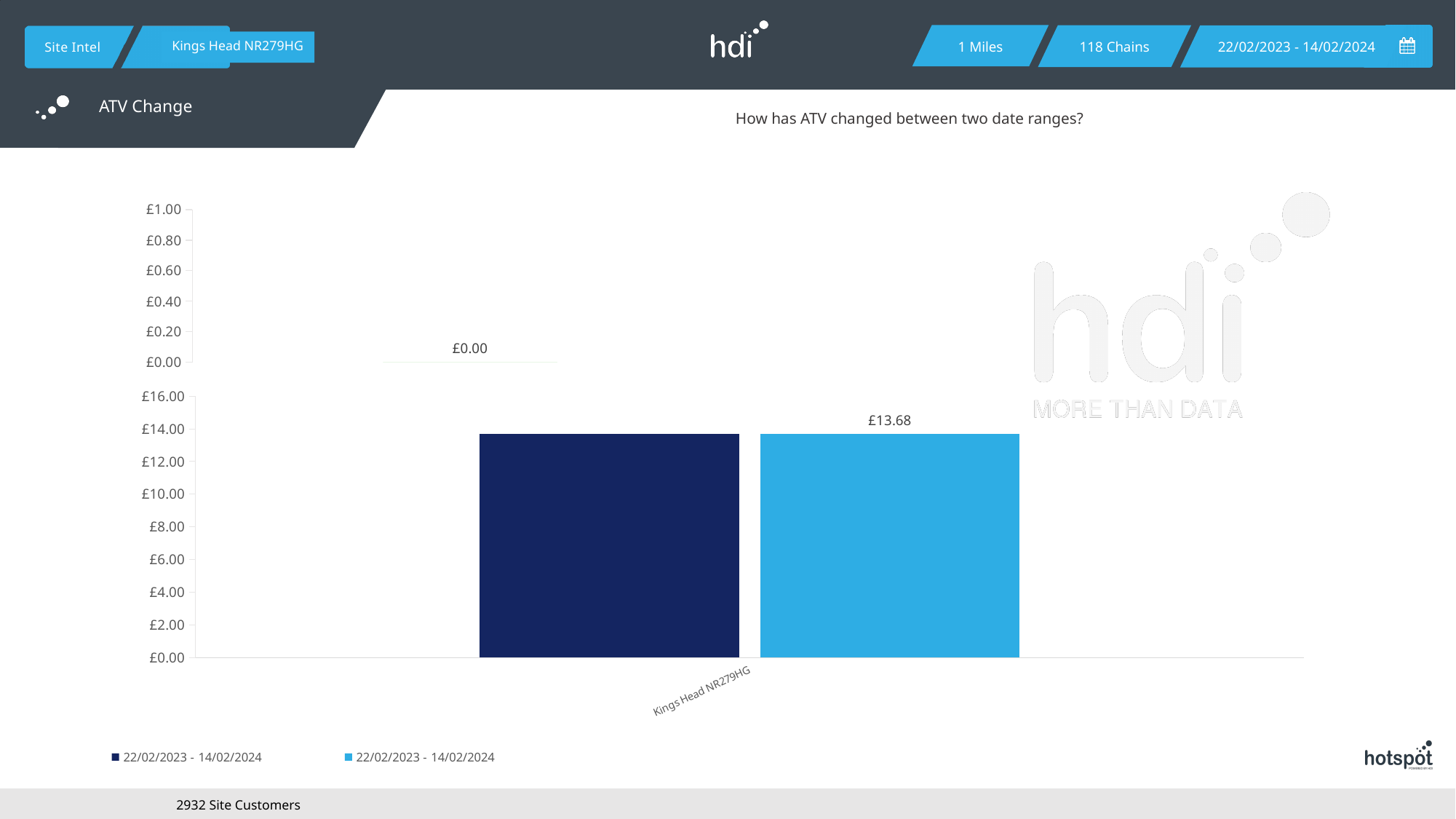
On the bottom chart, what is the value printed above the light blue bar for Kings Head NR279HG? £13.68 On the bottom chart, is the value of the dark blue bar greater or less than £8.00? greater How many series does the legend at the bottom of the slide list? 2 What is the category label shown on the x axis of the bottom chart? Kings Head NR279HG On the bottom chart, is the value of the light blue bar for Kings Head NR279HG greater or less than £10.00? greater On the bottom chart, is the value of the dark blue bar for Kings Head NR279HG greater or less than £12.00? greater What question is written as the heading above the charts? How has ATV changed between two date ranges? What kind of chart is the bottom chart on the slide? bar chart On the bottom chart, how many categories are shown on the x axis? 1 On the top chart, what value is printed as the data label? £0.00